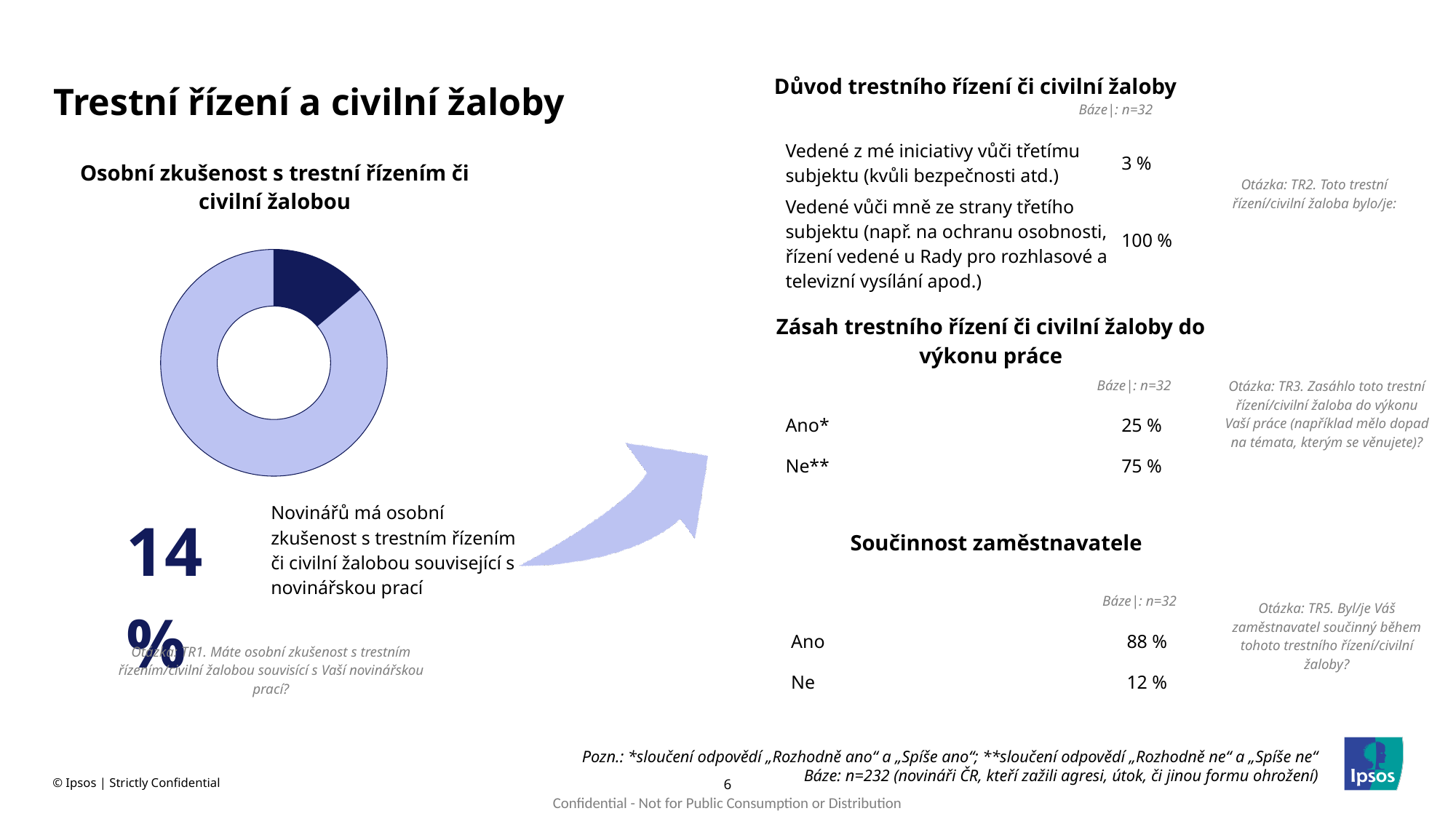
In the donut chart "Osobní zkušenost s trestní řízením či civilní žalobou", which slice is larger, the dark blue one or the light blue one? The light blue one How many slices does the donut chart "Osobní zkušenost s trestní řízením či civilní žalobou" have? 2 In the donut chart "Osobní zkušenost s trestní řízením či civilní žalobou", what share of journalists have personal experience with criminal proceedings or a civil lawsuit related to their journalistic work? 14 % What kind of chart is shown under the title "Osobní zkušenost s trestní řízením či civilní žalobou"? Donut (pie) chart What is the title of the donut chart on the left side of the slide? Osobní zkušenost s trestní řízením či civilní žalobou In the donut chart "Osobní zkušenost s trestní řízením či civilní žalobou", what value is printed next to the chart for the dark blue slice? 14 % In the donut chart "Osobní zkušenost s trestní řízením či civilní žalobou", what colour is the smaller slice? Dark blue